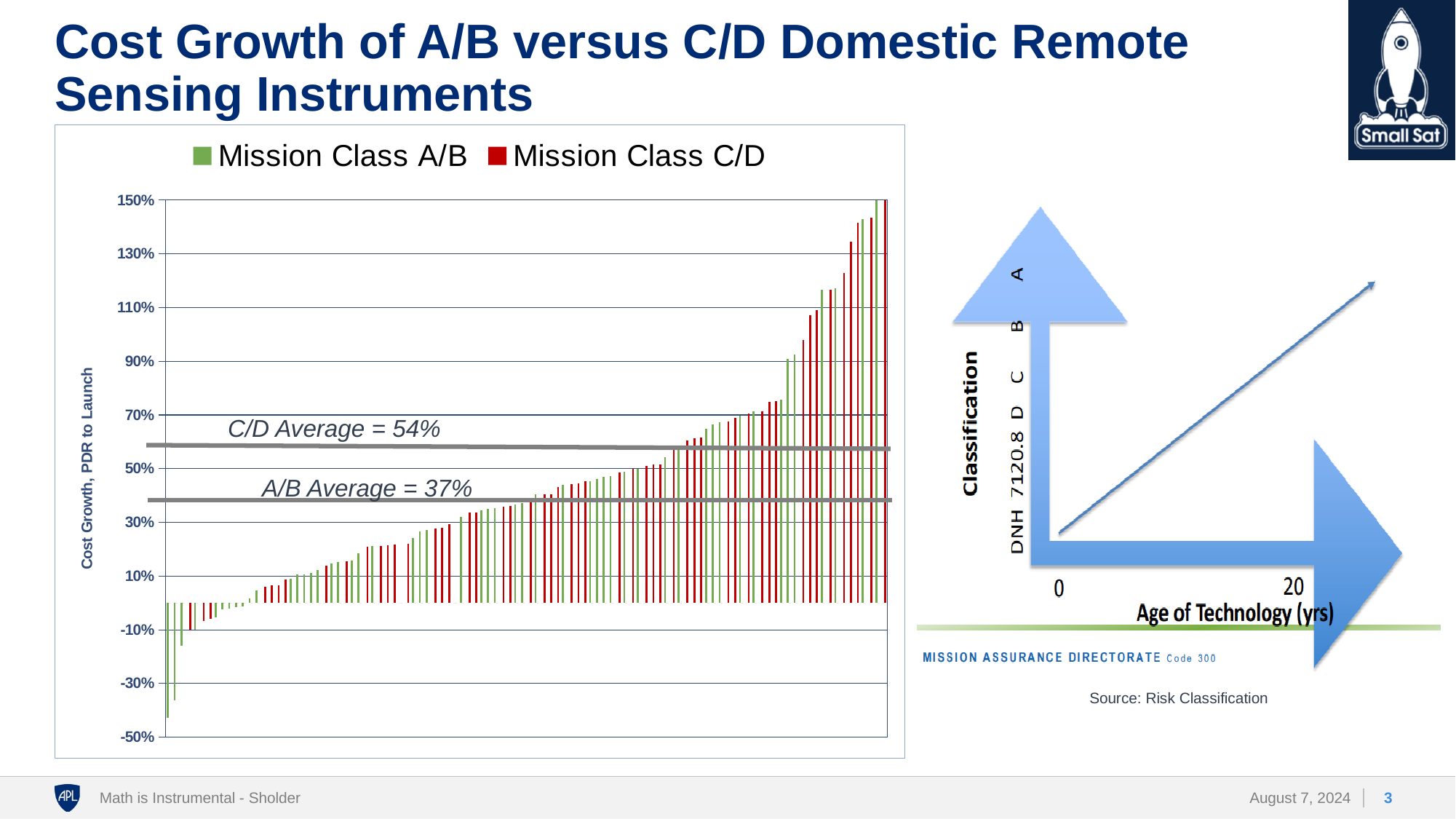
What is the label on the vertical axis of the chart? Cost Growth, PDR to Launch Is the value of the lowest bar in the chart greater or less than -30%? less Is the value of the tallest bar in the chart greater or less than 130%? greater What is the A/B Average value annotated on the chart? 37% What are the two series named in the chart legend? Mission Class A/B and Mission Class C/D What kind of chart is shown on the left of the slide? bar chart Which is larger, the C/D Average or the A/B Average? C/D Average How many series does the legend of the chart list? 2 By how many percentage points does the C/D Average exceed the A/B Average? 17 percentage points Do the bar values rise or fall from left to right across the chart? rise What is the highest tick value shown on the vertical axis of the chart? 150% What is the C/D Average value annotated on the chart? 54%